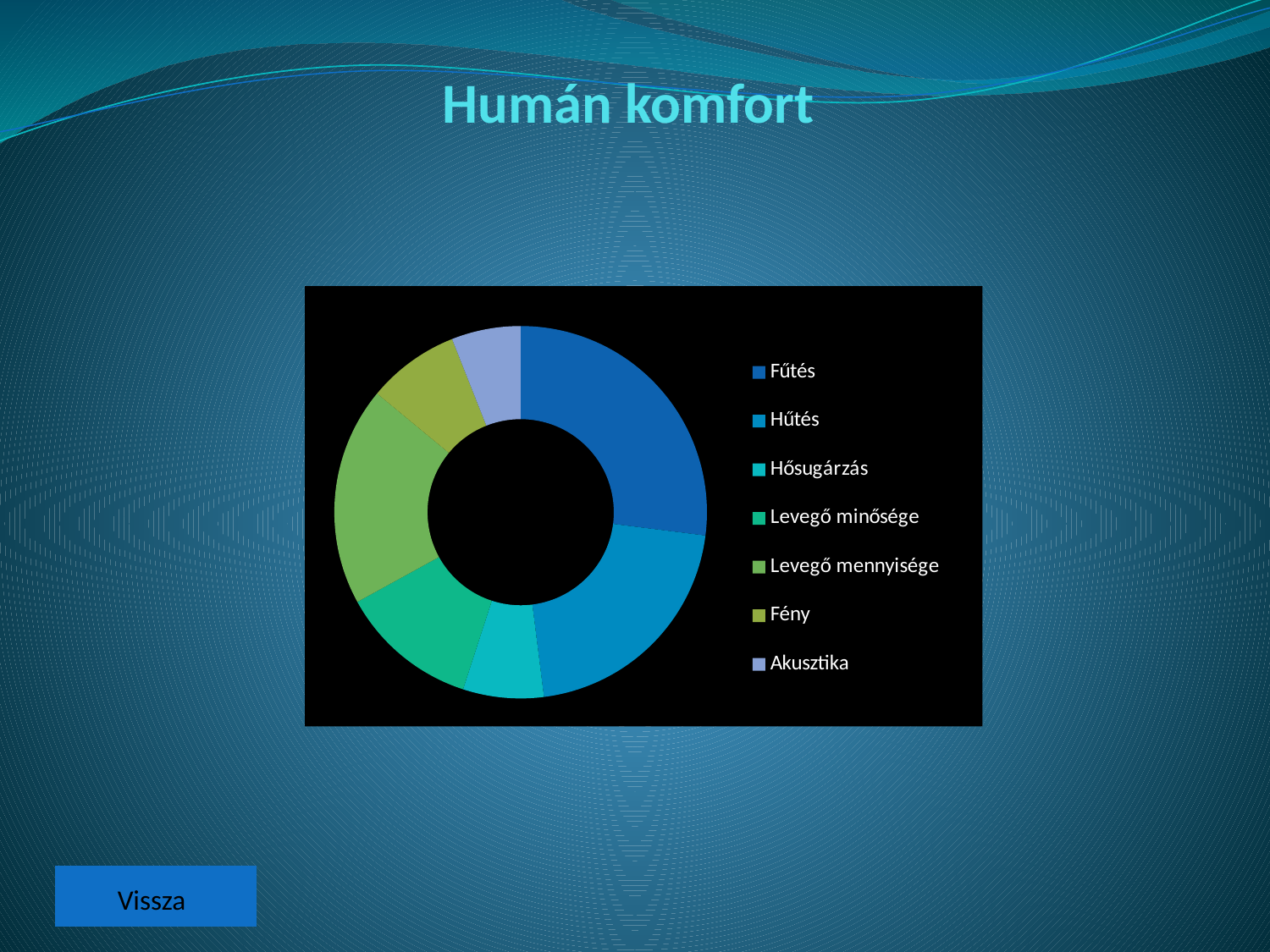
Which slice is larger, Fűtés or Hűtés? Fűtés Which slice is larger, Levegő mennyisége or Fény? Levegő mennyisége How many categories does the chart show? 7 How many entries does the chart legend list? 7 Which category has the largest slice in the chart? Fűtés Which slice is larger, Fűtés or Akusztika? Fűtés Which legend entry is listed last in the chart legend? Akusztika What is the title of the slide containing the chart? Humán komfort What kind of chart is shown on the slide? Doughnut (pie) chart